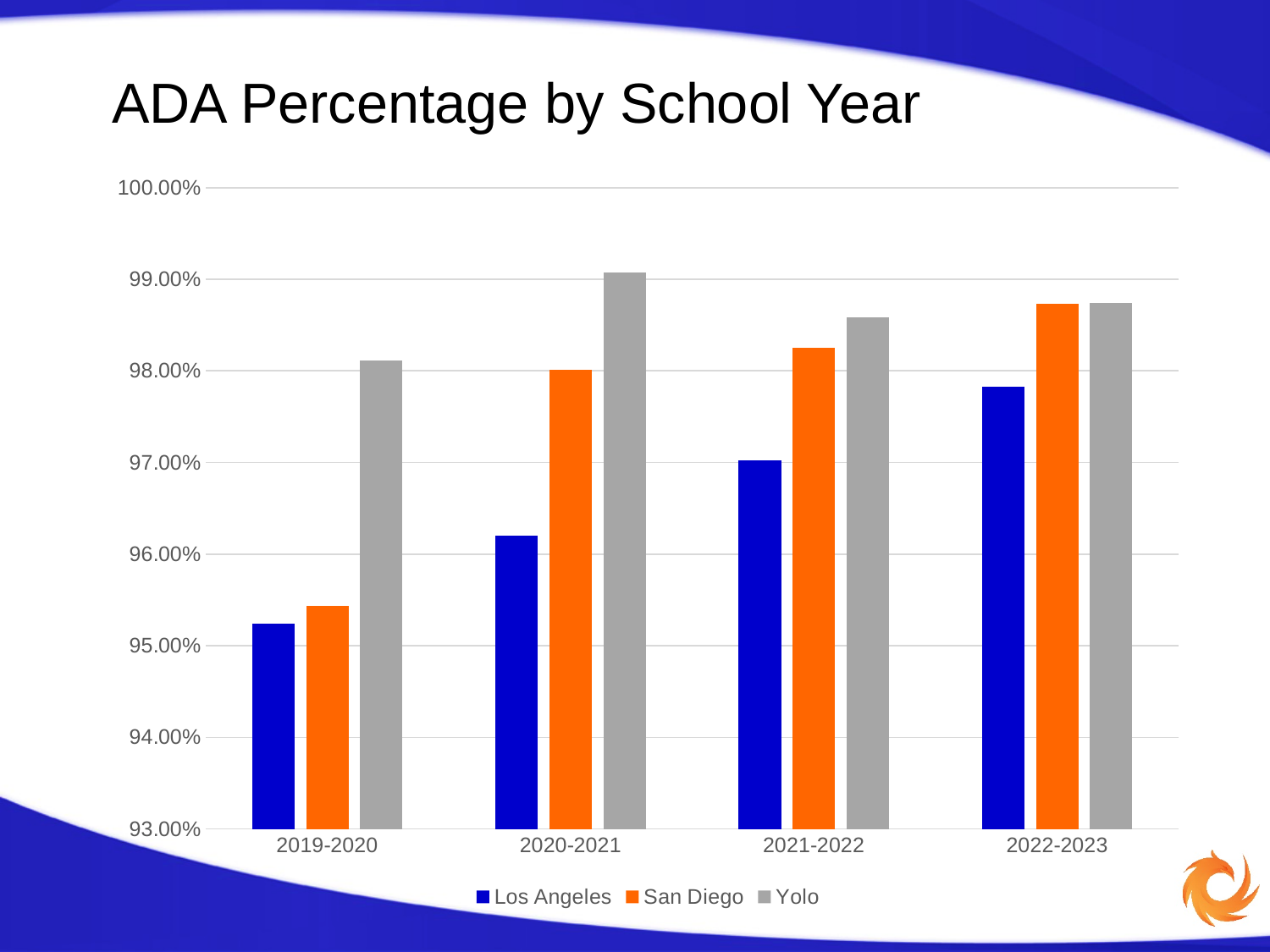
Do the Los Angeles values rise or fall from 2019-2020 to 2022-2023? rise Is the value for Los Angeles in 2021-2022 greater or less than 98.00%? less In which school year is the Los Angeles bar the lowest? 2019-2020 In 2021-2022, which is larger: the San Diego value or the Los Angeles value? San Diego How many series does the legend list? 3 Is the value for Los Angeles in 2019-2020 greater or less than 96.00%? less What is the title of the chart? ADA Percentage by School Year In which school year is the Yolo bar the highest? 2020-2021 Is the value for Yolo in 2020-2021 greater or less than 98.00%? greater In 2019-2020, which is larger: the Yolo value or the San Diego value? Yolo What kind of chart is shown on the slide? Bar chart How many school years are shown on the x axis? 4